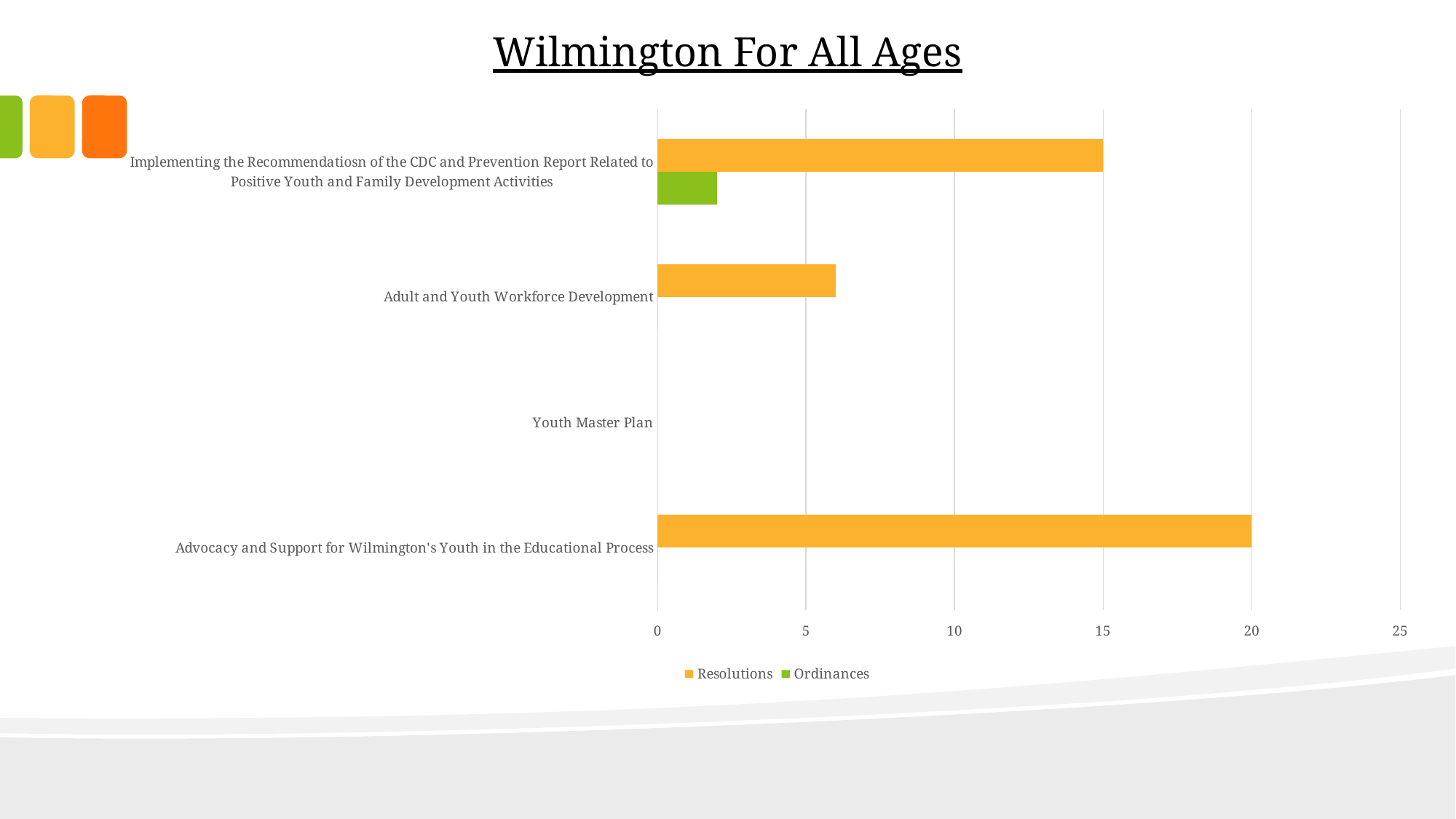
What is the difference between the Resolutions values for Advocacy and Support for Wilmington's Youth in the Educational Process and Implementing the Recommendatiosn of the CDC and Prevention Report? 5 What kind of chart is shown on the slide? bar chart How many series does the legend list? 2 What are the two series named in the legend? Resolutions and Ordinances Which has the larger Resolutions value: Advocacy and Support for Wilmington's Youth in the Educational Process or Adult and Youth Workforce Development? Advocacy and Support for Wilmington's Youth in the Educational Process What is the title of the slide? Wilmington For All Ages What is the Resolutions value for Advocacy and Support for Wilmington's Youth in the Educational Process? 20 Is the Ordinances value for Implementing the Recommendatiosn of the CDC and Prevention Report greater or less than 5? less Is the Resolutions value for Adult and Youth Workforce Development greater or less than 10? less Which category has the highest Resolutions value? Advocacy and Support for Wilmington's Youth in the Educational Process How many categories are shown on the chart? 4 What is the Resolutions value for Implementing the Recommendatiosn of the CDC and Prevention Report Related to Positive Youth and Family Development Activities? 15